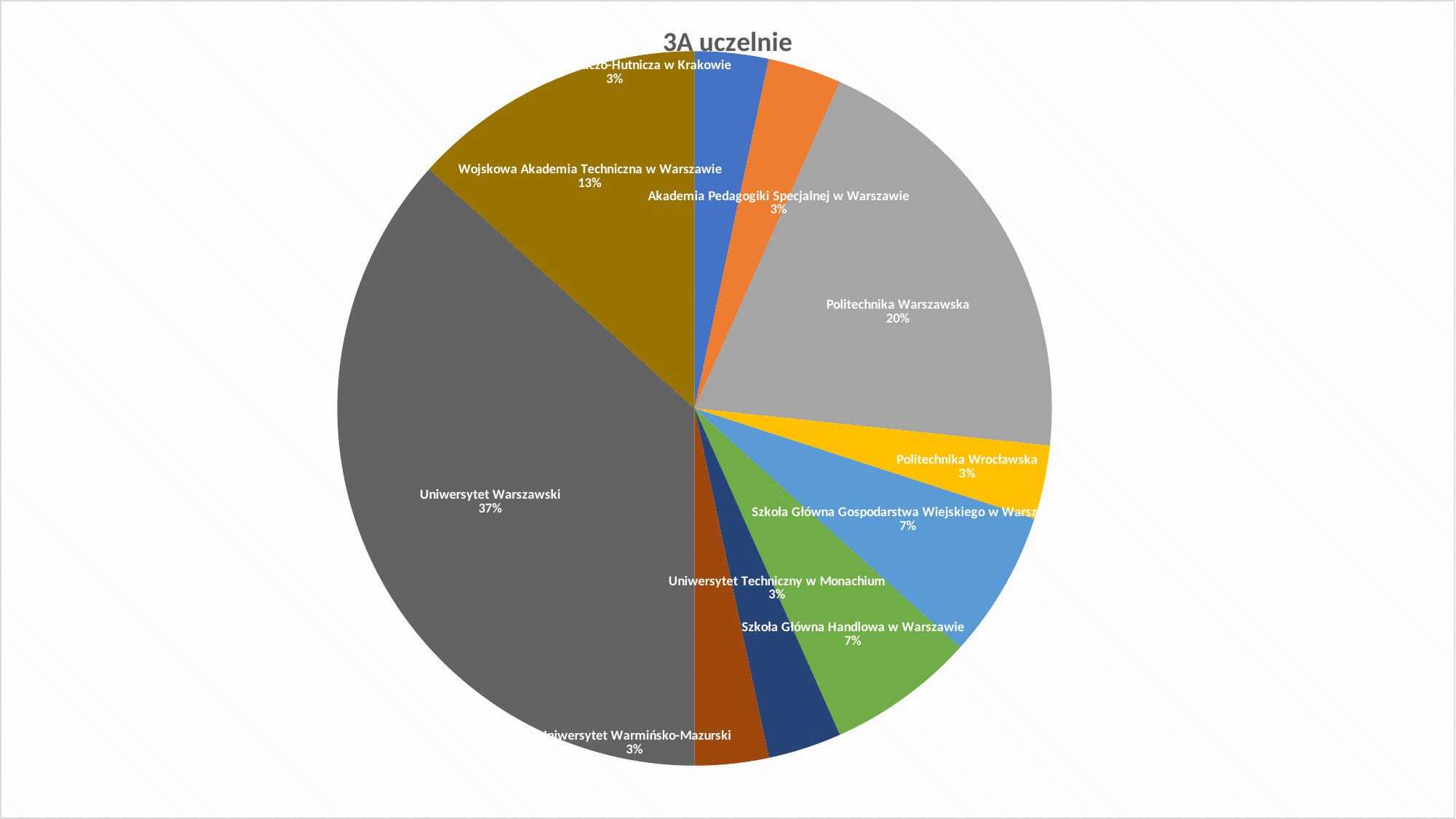
What percentage is shown for Politechnika Warszawska? 20% What percentage is shown for Wojskowa Akademia Techniczna w Warszawie? 13% What percentage is shown for Politechnika Wrocławska? 3% Which university has the largest share of the pie? Uniwersytet Warszawski What is the difference in percentage points between Uniwersytet Warszawski and Politechnika Warszawska? 17 Which has a larger share, Politechnika Warszawska or Wojskowa Akademia Techniczna w Warszawie? Politechnika Warszawska What percentage is shown for Szkoła Główna Handlowa w Warszawie? 7% What kind of chart is shown on the slide? pie chart What is the title of the chart? 3A uczelnie How many slices does the pie chart have? 10 What percentage is shown for Uniwersytet Techniczny w Monachium? 3% What share of the pie does Uniwersytet Warszawski have? 37%